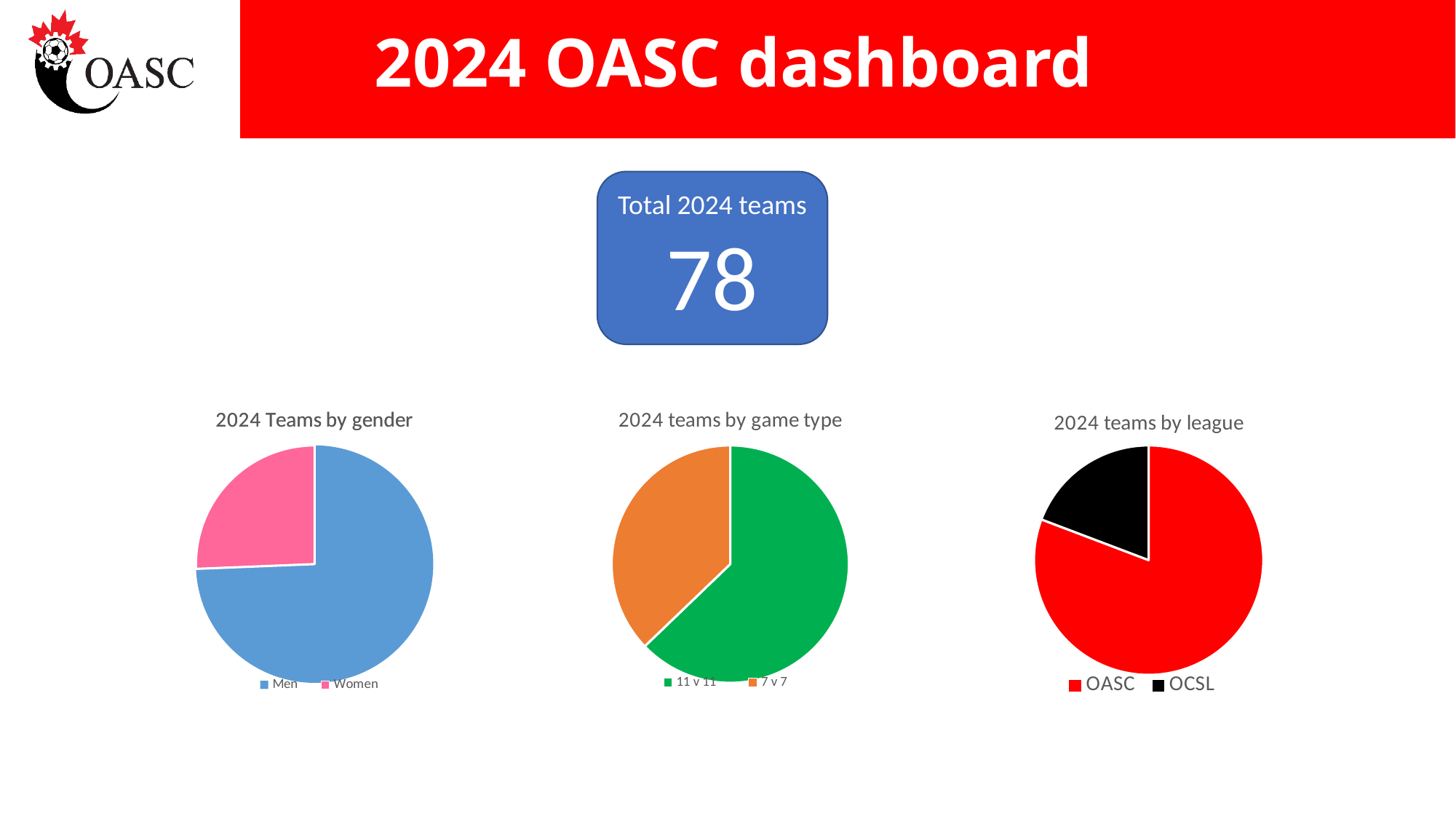
In the "2024 teams by league" chart, which league has the largest slice? OASC In the "2024 teams by game type" chart, which slice is larger, 11 v 11 or 7 v 7? 11 v 11 In the "2024 teams by league" chart, which league has the smallest slice? OCSL How many categories does the "2024 Teams by gender" chart show? 2 How many entries does the legend of the "2024 teams by game type" chart list? 2 In the "2024 teams by league" chart, what colour is the OCSL slice? black In the "2024 Teams by gender" chart, which category has the smallest slice? Women In the "2024 Teams by gender" chart, which category has the largest slice? Men What kind of chart is the "2024 teams by game type" chart? pie chart What is the title of the leftmost chart on the slide? 2024 Teams by gender What kind of chart is the "2024 Teams by gender" chart? pie chart How many categories does the "2024 teams by league" chart show? 2